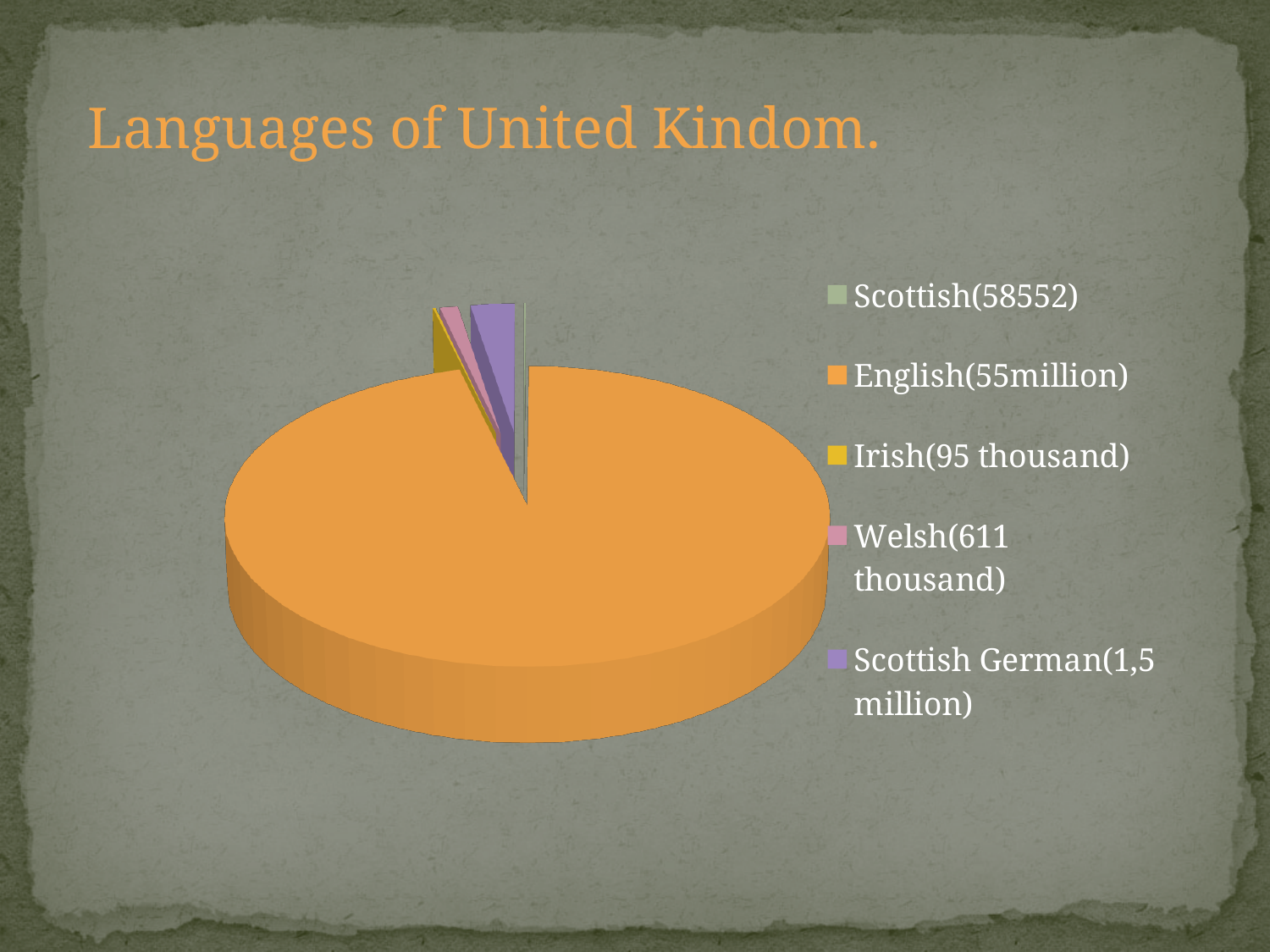
What value is given for Irish in the legend? 95 thousand What kind of chart is shown on the slide? Pie chart What colour is the English slice of the pie? Orange What value is given for English in the legend? 55million What is the title of the chart? Languages of United Kindom. Which is larger, the slice for English or the slice for Scottish German? English How many languages (slices) does the pie chart show? 5 What value is given for Welsh in the legend? 611 thousand What is the difference between the Welsh value and the Irish value shown in the legend? 516 thousand What value is given for Scottish German in the legend? 1,5 million Which language has the largest slice of the pie? English Which language has the smallest value according to the legend? Scottish